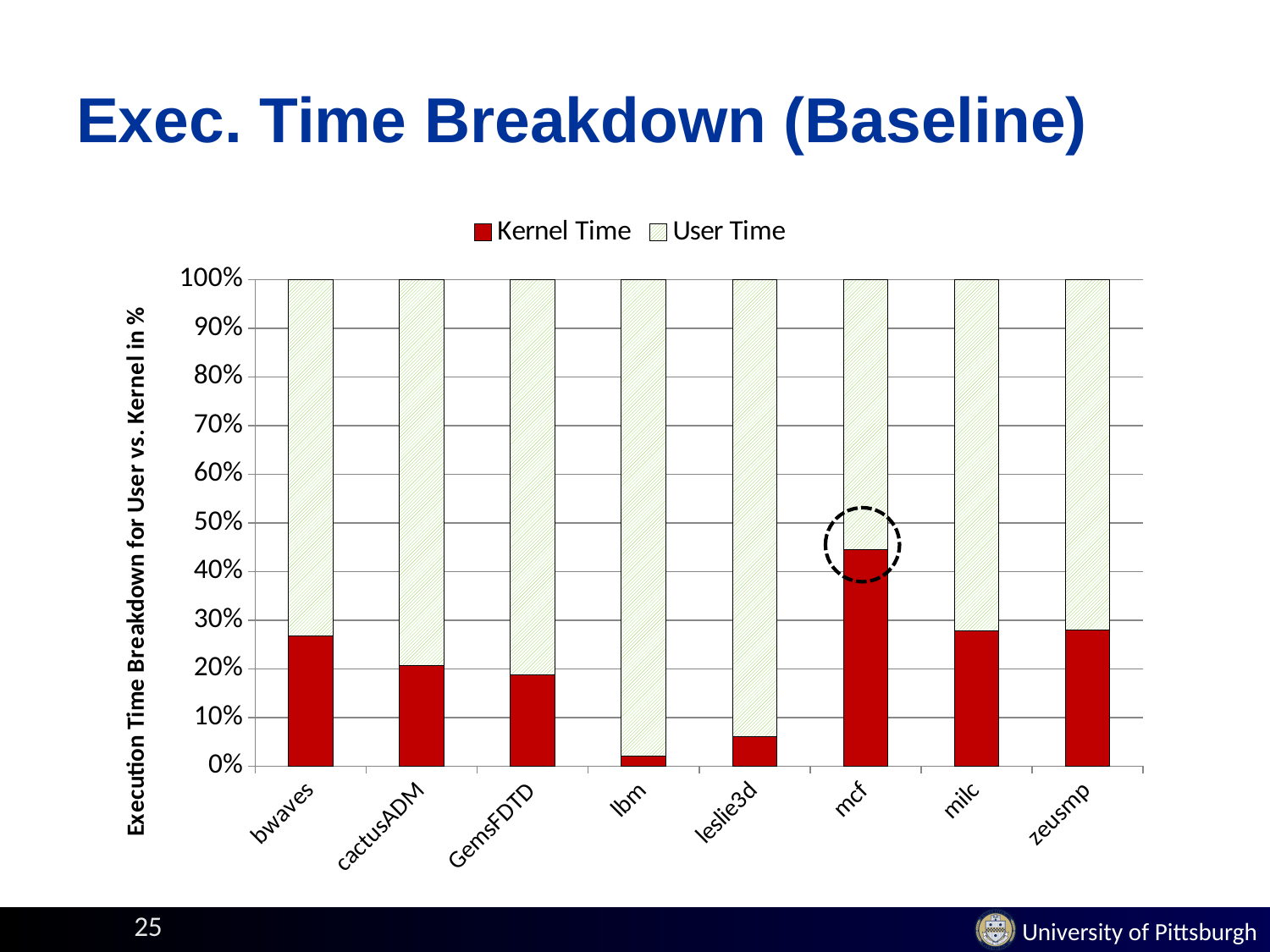
Which has a larger Kernel Time share, leslie3d or lbm? leslie3d Is the Kernel Time value for mcf greater or less than 40%? greater What kind of chart is shown on the slide? stacked bar chart Is the Kernel Time value for bwaves greater or less than 20%? greater Which benchmark has the lowest Kernel Time share? lbm What is the total height of each stacked bar? 100% How many series does the legend list? 2 How many benchmarks (categories) are shown on the x axis? 8 Which has a larger Kernel Time share, mcf or bwaves? mcf Is the Kernel Time value for lbm greater or less than 10%? less Which benchmark's bar is highlighted with a dashed circle? mcf Which benchmark has the highest Kernel Time share? mcf